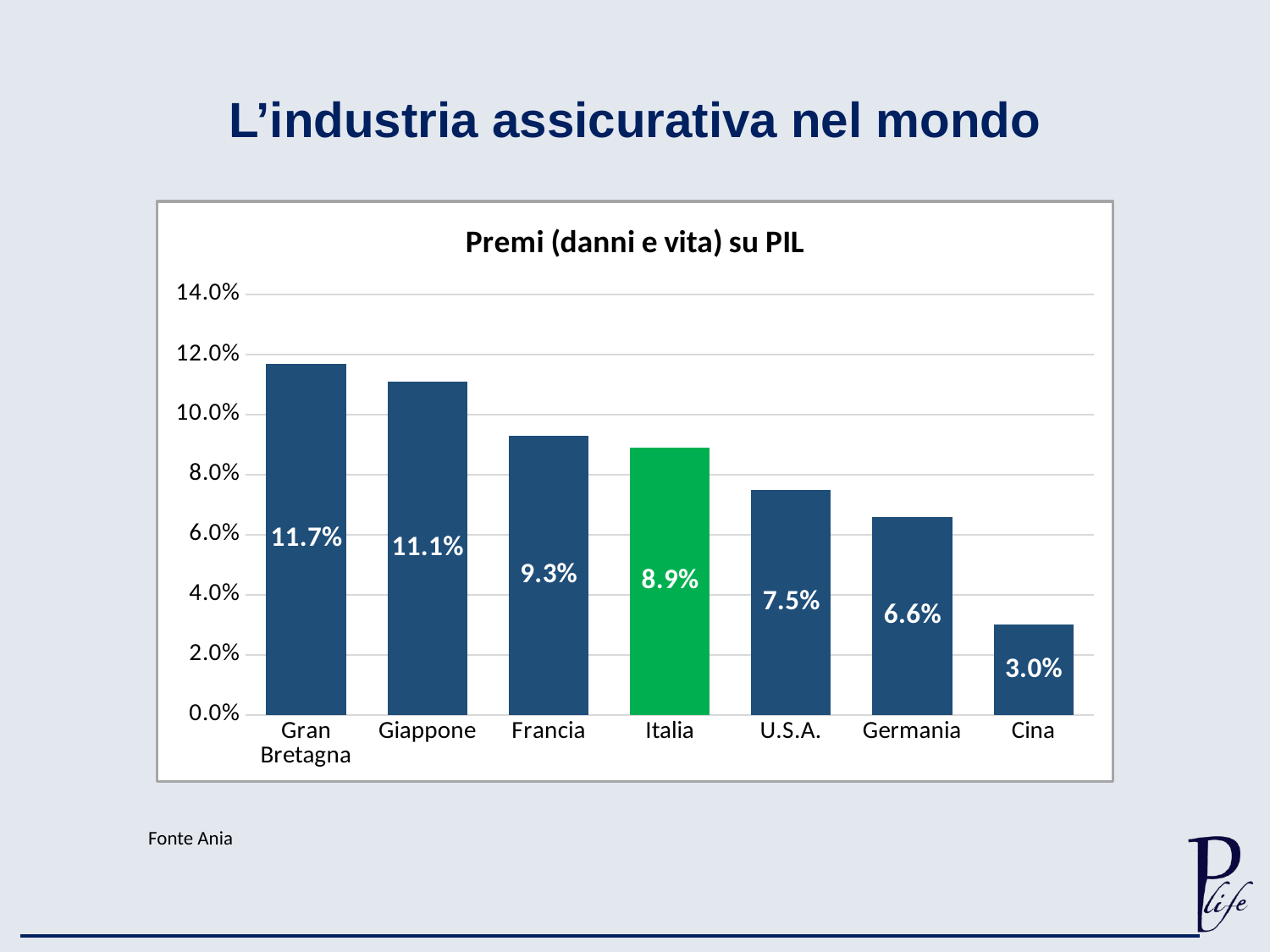
Do the values rise or fall from left to right along the x axis? fall Which is larger, the value for U.S.A. or the value for Germania? U.S.A. What is the value for Italia? 8.9% Which country has the highest value? Gran Bretagna Is the value for Francia greater or less than 10.0%? less What is the value for Germania? 6.6% What is the title of the chart? Premi (danni e vita) su PIL What is the difference between the values for Giappone and Francia? 1.8% What is the value for Gran Bretagna? 11.7% How many countries are shown in the chart? 7 Which country has the lowest value? Cina What kind of chart is shown on the slide? bar chart